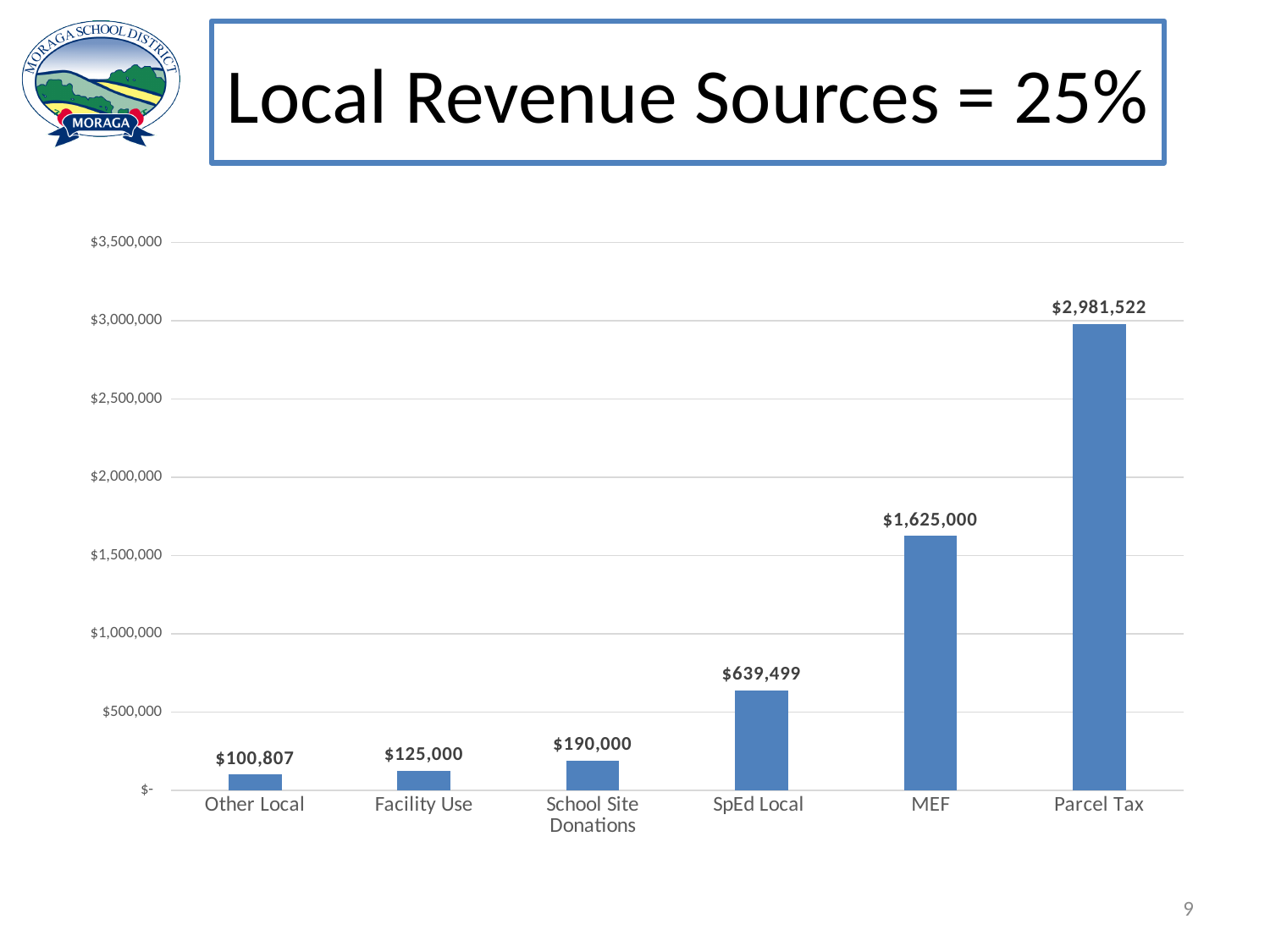
What kind of chart is shown on the slide? Bar chart What is the value for Parcel Tax? $2,981,522 What is the difference between the values for Facility Use and Other Local? $24,193 Which category has the highest value? Parcel Tax Which category has the lowest value? Other Local How many categories are shown on the x axis? 6 What is the value for MEF? $1,625,000 What is the difference between the values for Parcel Tax and MEF? $1,356,522 What is the value for SpEd Local? $639,499 What is the value for School Site Donations? $190,000 Is the value for MEF greater or less than $1,500,000? greater Which is larger, the value for SpEd Local or the value for School Site Donations? SpEd Local